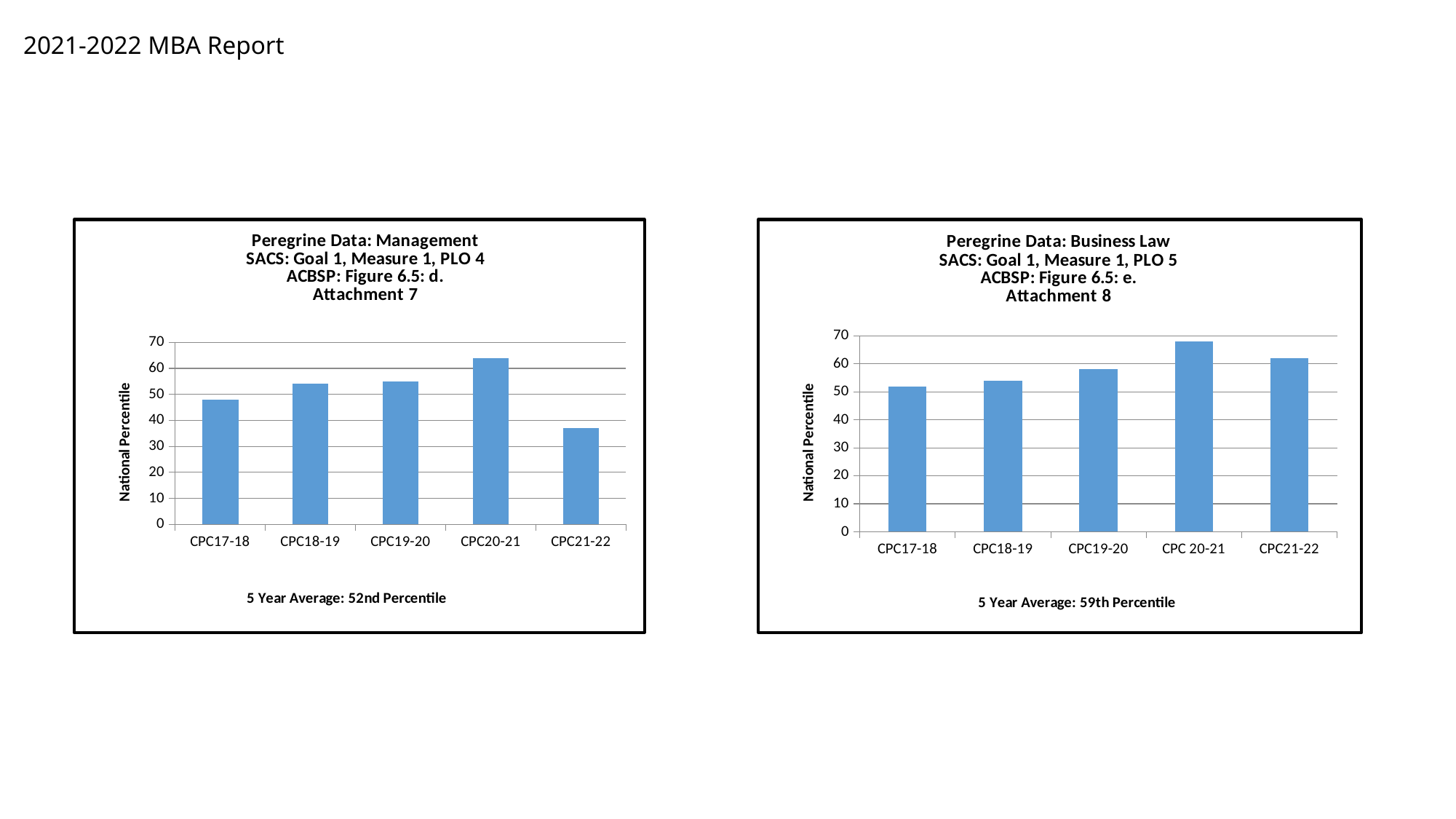
In the Peregrine Data: Business Law chart, which category has the highest bar? CPC 20-21 In the Peregrine Data: Management chart, is the value for CPC20-21 greater or less than 60? greater In the Peregrine Data: Business Law chart, which category has the lowest bar? CPC17-18 In the Peregrine Data: Business Law chart, which is larger, the value for CPC18-19 or the value for CPC21-22? CPC21-22 In the Peregrine Data: Management chart, is the value for CPC21-22 greater or less than 40? less In the Peregrine Data: Management chart, which category has the highest bar? CPC20-21 In the Peregrine Data: Management chart, which is larger, the value for CPC17-18 or the value for CPC20-21? CPC20-21 In the Peregrine Data: Business Law chart, is the value for CPC21-22 greater or less than 60? greater In the Peregrine Data: Management chart, which category has the lowest bar? CPC21-22 What 5 year average is stated below the Peregrine Data: Business Law chart? 59th Percentile What kind of chart is the Peregrine Data: Business Law chart? bar chart How many categories are shown on the x axis of the Peregrine Data: Management chart? 5